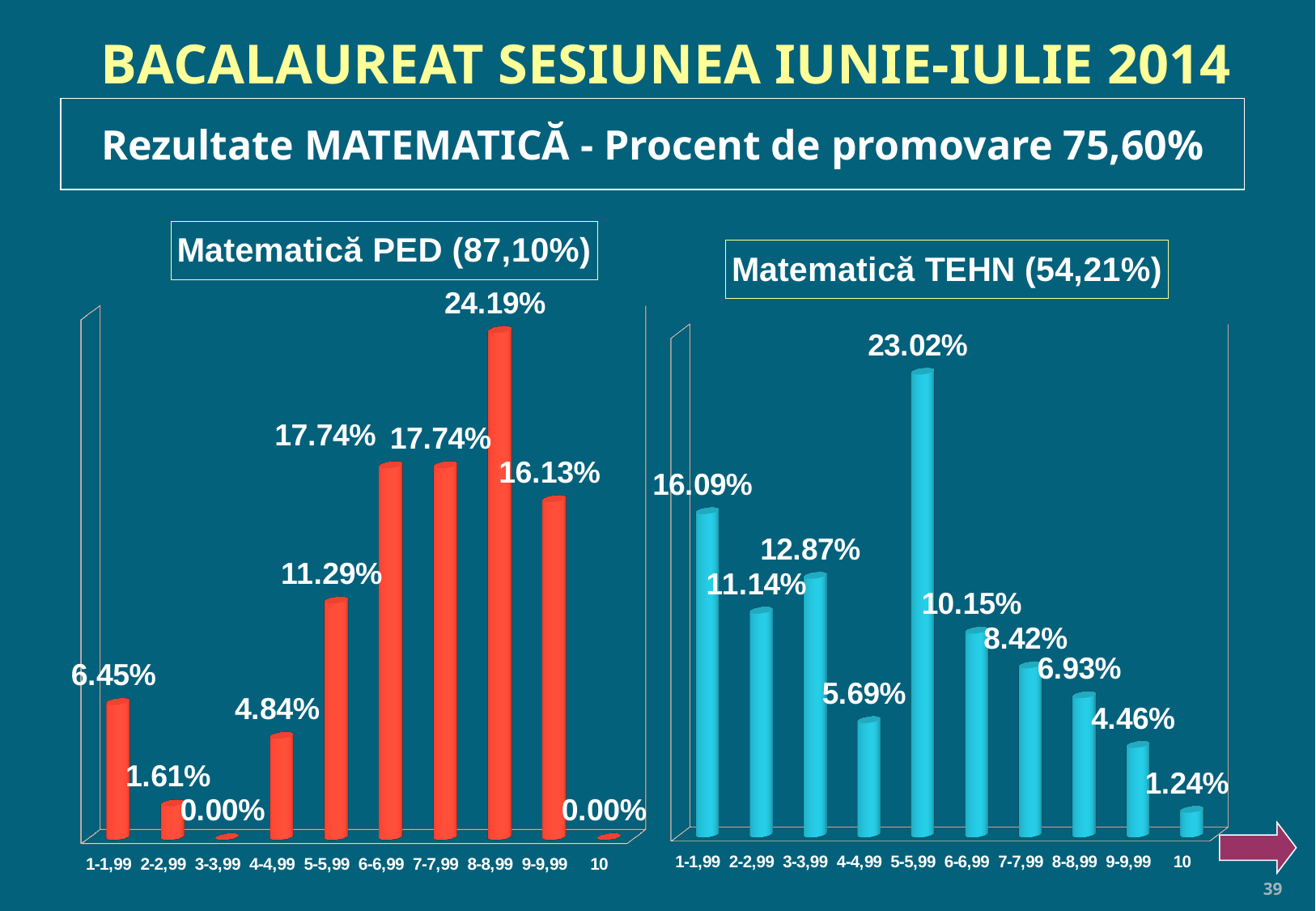
In the Matematică TEHN chart, which category has the highest value? 5-5,99 In the Matematică PED chart, what is the value for the 5-5,99 category? 11.29% How many categories are shown in the Matematică PED chart? 10 In the Matematică TEHN chart, which is larger, the value for 3-3,99 or the value for 4-4,99? 3-3,99 What type of chart is the Matematică TEHN chart? Bar chart In the Matematică PED chart, which category has the highest value? 8-8,99 In the Matematică TEHN chart, what is the difference between the values for 1-1,99 and 2-2,99? 4.95% In the Matematică TEHN chart, which category has the lowest value? 10 In the Matematică PED chart, what is the value for the 8-8,99 category? 24.19% In the Matematică PED chart, what is the difference between the values for 8-8,99 and 9-9,99? 8.06% In the Matematică TEHN chart, what is the value for the 10 category? 1.24% In the Matematică TEHN chart, what is the value for the 5-5,99 category? 23.02%